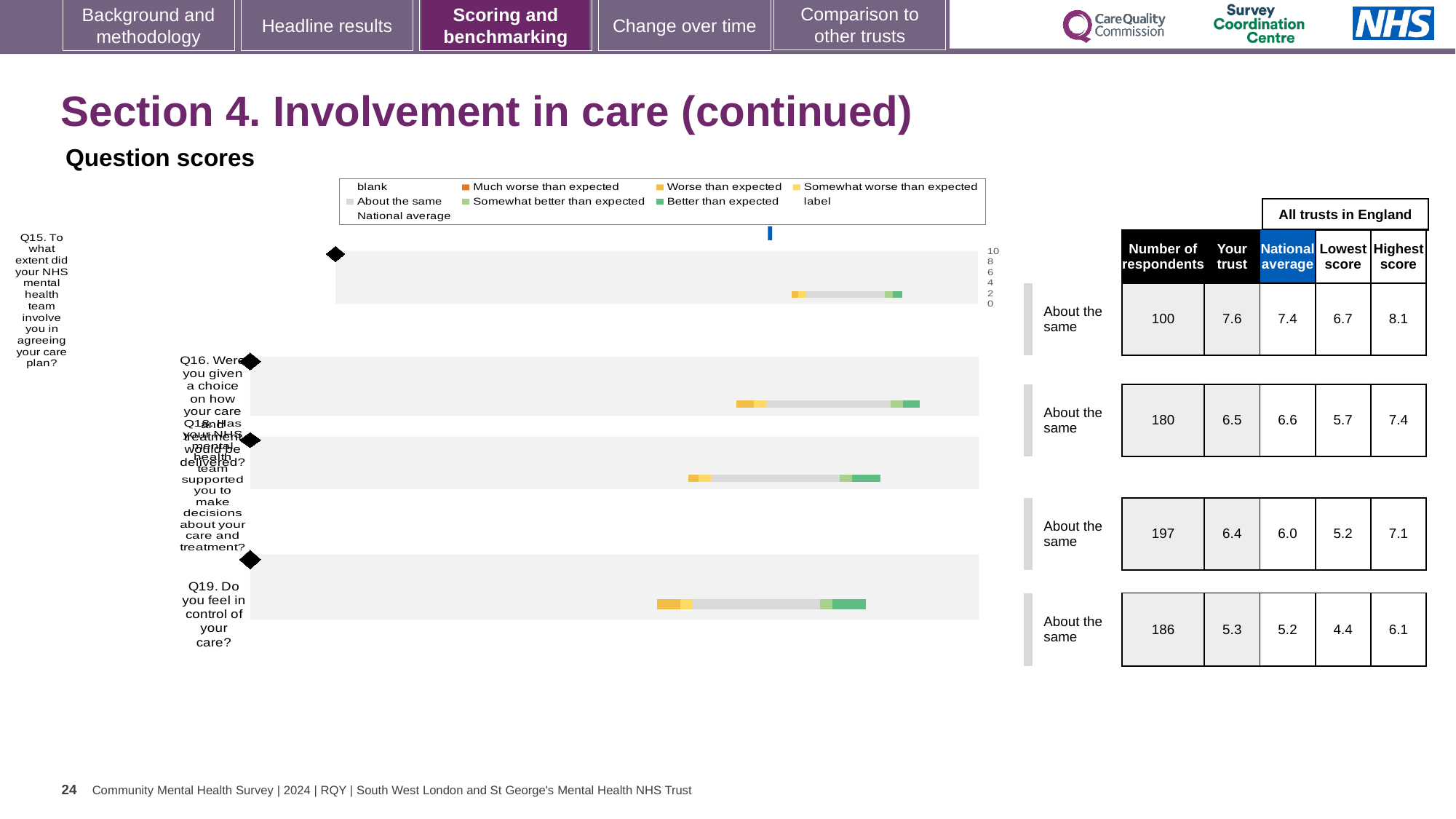
What kind of chart is used to show the question scores on this slide? bar chart For Q16, which is larger: the 'Your trust' score or the national average? National average What is the national average score for Q19 (Do you feel in control of your care?)? 5.2 How many questions (categories) are plotted in the question scores chart? 4 How many respondents answered Q18 (Has your NHS mental health team supported you to make decisions about your care and treatment?)? 197 What colour does the legend use for 'Much worse than expected'? Orange What is the highest score among all trusts in England for Q16? 7.4 Which question has the highest 'Your trust' score? Q15 What is the difference between the 'Your trust' score and the national average for Q15? 0.2 Which question has the lowest 'Your trust' score? Q19 What is the 'Your trust' score for Q15 (To what extent did your NHS mental health team involve you in agreeing your care plan?)? 7.6 What benchmark category is shown for Q18 next to the chart? About the same